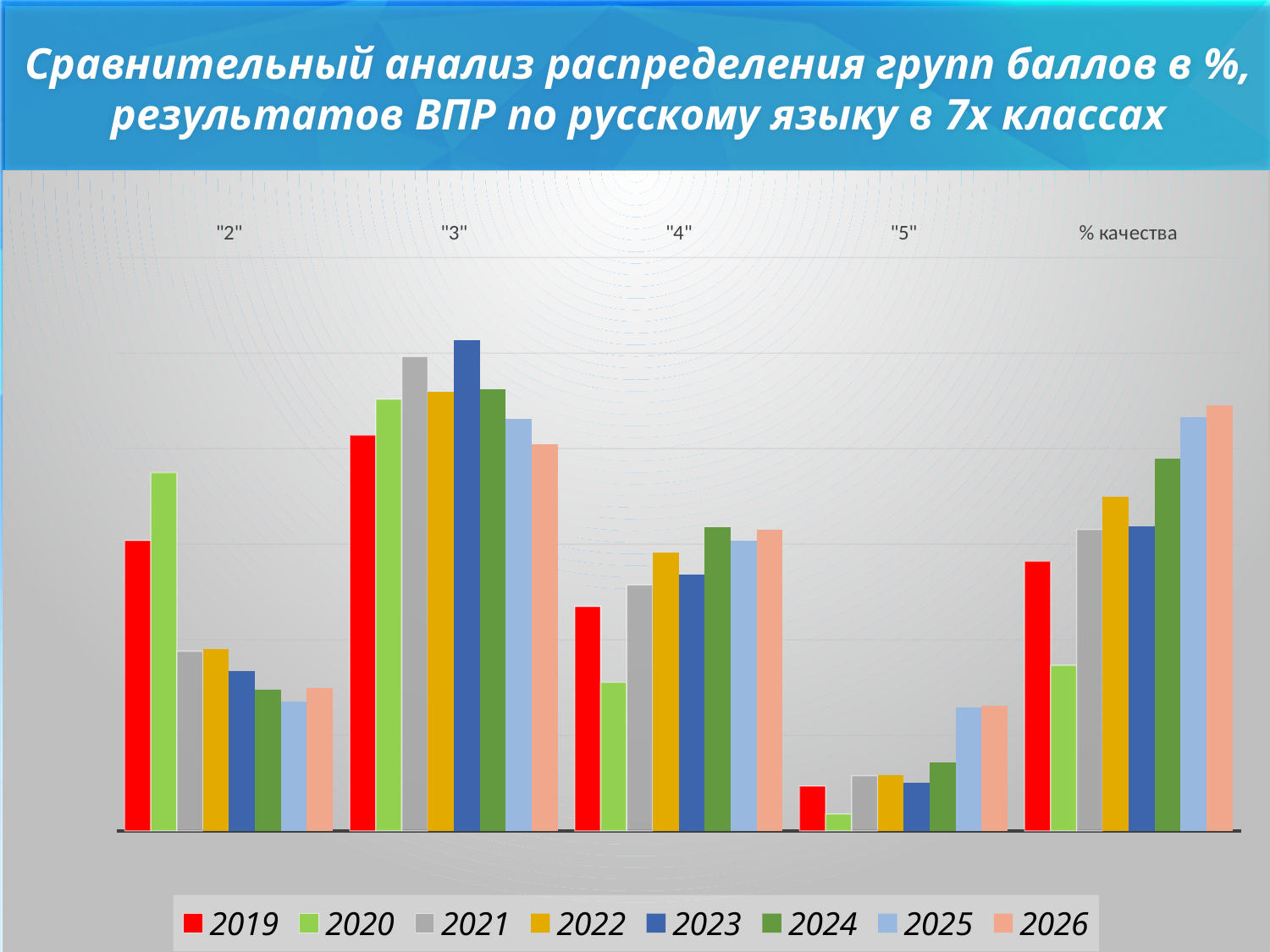
In the "4" category, which year has the lowest value? 2020 Which year is shown in red in the legend? 2019 In the "5" category, which year has the lowest value? 2020 What kind of chart is shown on the slide? bar chart In the "3" category, which year has the highest value? 2023 In the "2" category, which year has the highest value? 2020 How many categories are shown along the x axis? 5 How many series does the legend list? 8 Which year is the last entry in the legend? 2026 In the "2" category, which is larger: the value for 2019 or for 2021? 2019 In the "% качества" category, which is larger: the value for 2024 or for 2019? 2024 In the "% качества" category, which year has the lowest value? 2020